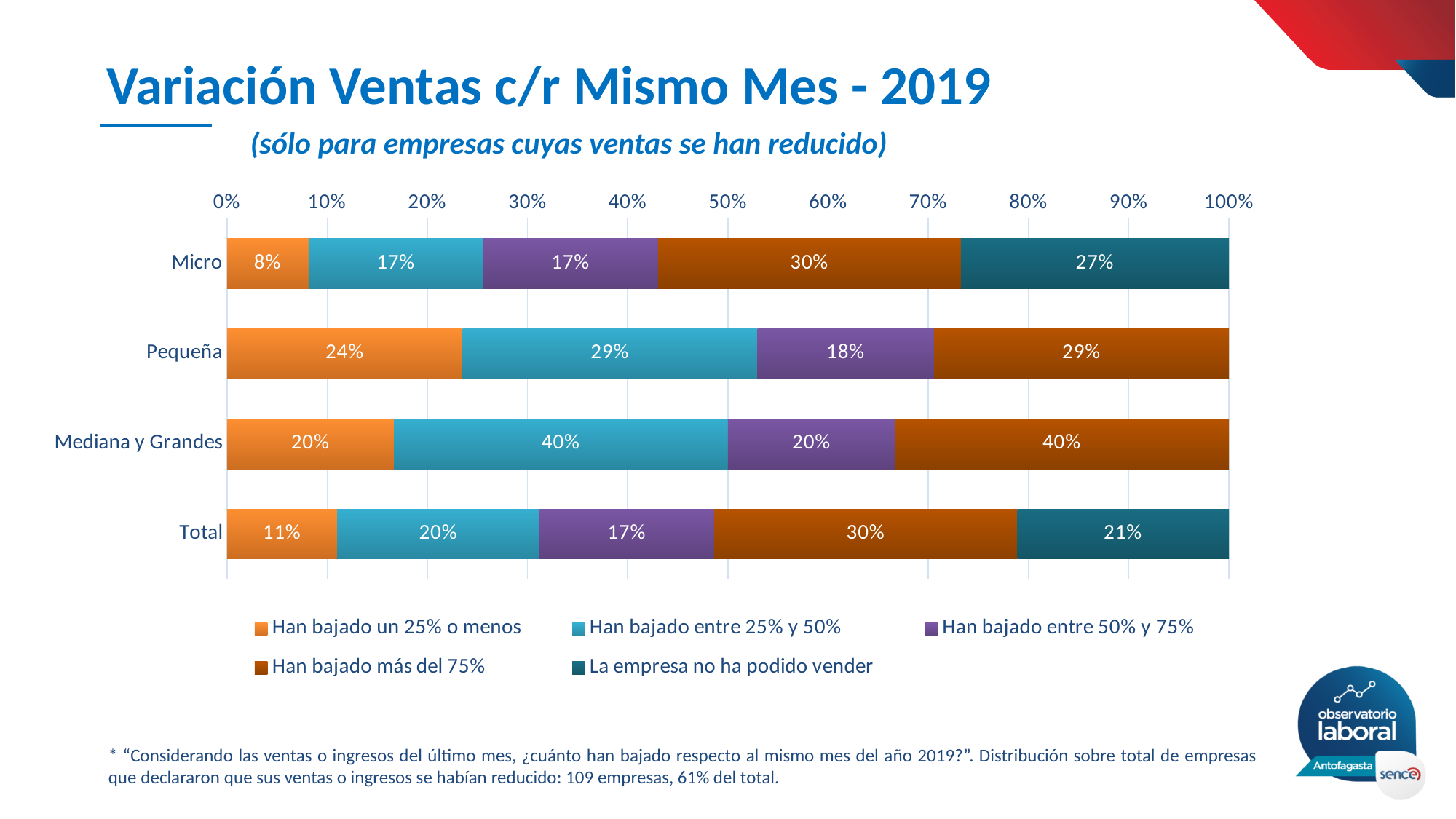
How many series does the legend list? 5 Which legend entry is shown in purple? Han bajado entre 50% y 75% What is the difference between the 'Han bajado más del 75%' values for Mediana y Grandes and Micro? 10% What is the value for 'Han bajado entre 25% y 50%' in the Mediana y Grandes category? 40% What kind of chart is shown on the slide? Stacked bar chart What is the value for 'La empresa no ha podido vender' in the Total category? 21% Which category has the lowest value for 'Han bajado entre 25% y 50%'? Micro What is the value for 'Han bajado un 25% o menos' in the Micro category? 8% Which category has the highest value for 'Han bajado un 25% o menos'? Pequeña How many categories are plotted on the y axis of the chart? 4 What is the value for 'Han bajado entre 50% y 75%' in the Pequeña category? 18% Which is larger: 'La empresa no ha podido vender' for Micro or for Total? Micro